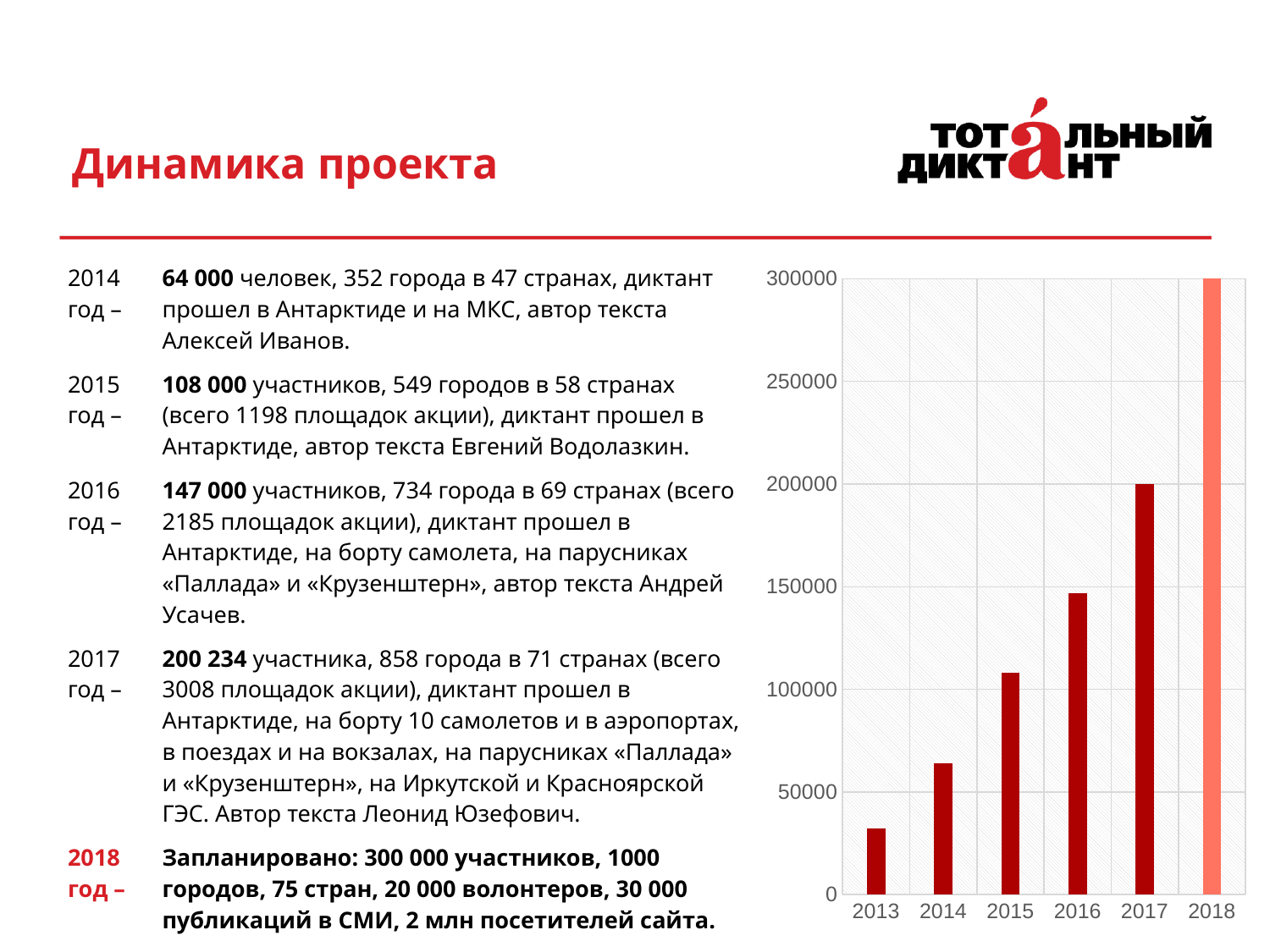
Do the bar values rise or fall from 2013 to 2018? rise What value does the bar for 2018 reach on the y axis? 300000 Which year's bar is drawn in a lighter colour than the others? 2018 Is the value for 2013 greater or less than 50000? less What kind of chart is shown on the slide? bar chart Which year has the larger bar, 2015 or 2016? 2016 Which year has the highest bar in the chart? 2018 Is the value for 2017 greater or less than 150000? greater How many years are shown on the x axis of the chart? 6 Which year has the lowest bar in the chart? 2013 Is the value for 2016 greater or less than 100000? greater